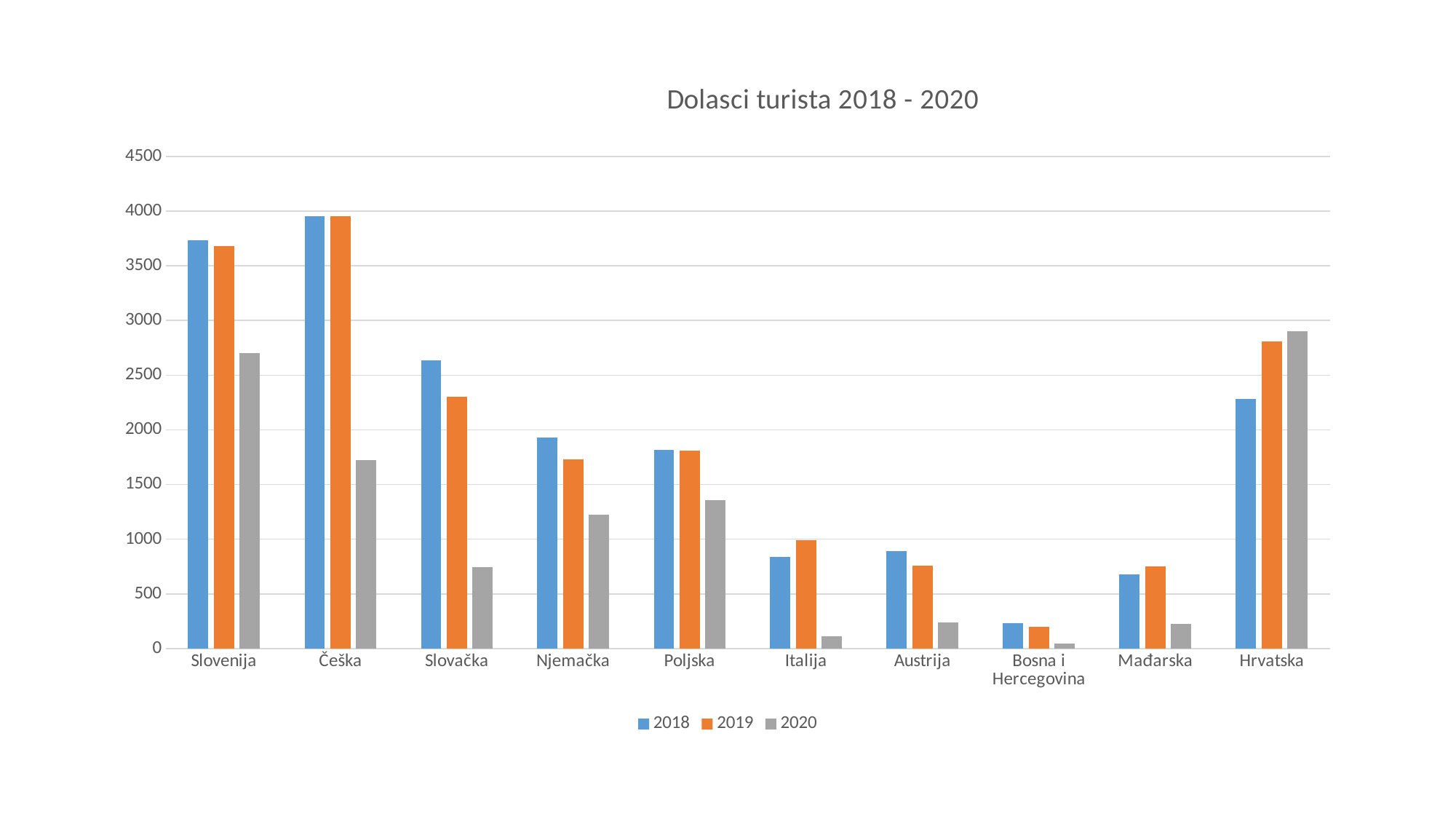
How many series does the legend list? 3 Is the 2018 value for Slovačka greater or less than 2500? greater How many countries are shown on the x axis? 10 What kind of chart is shown on the slide? bar chart Which country has the lowest value for 2020? Bosna i Hercegovina Which is larger, the 2019 value for Hrvatska or the 2019 value for Slovačka? Hrvatska Is the 2020 value for Slovenija greater or less than 2500? greater For Italija, which is larger, the 2018 value or the 2019 value? 2019 Which country has the highest value for 2018? Češka Which country has the highest value for 2020? Hrvatska Is the 2020 value for Češka greater or less than 2000? less What is the title of the chart? Dolasci turista 2018 - 2020